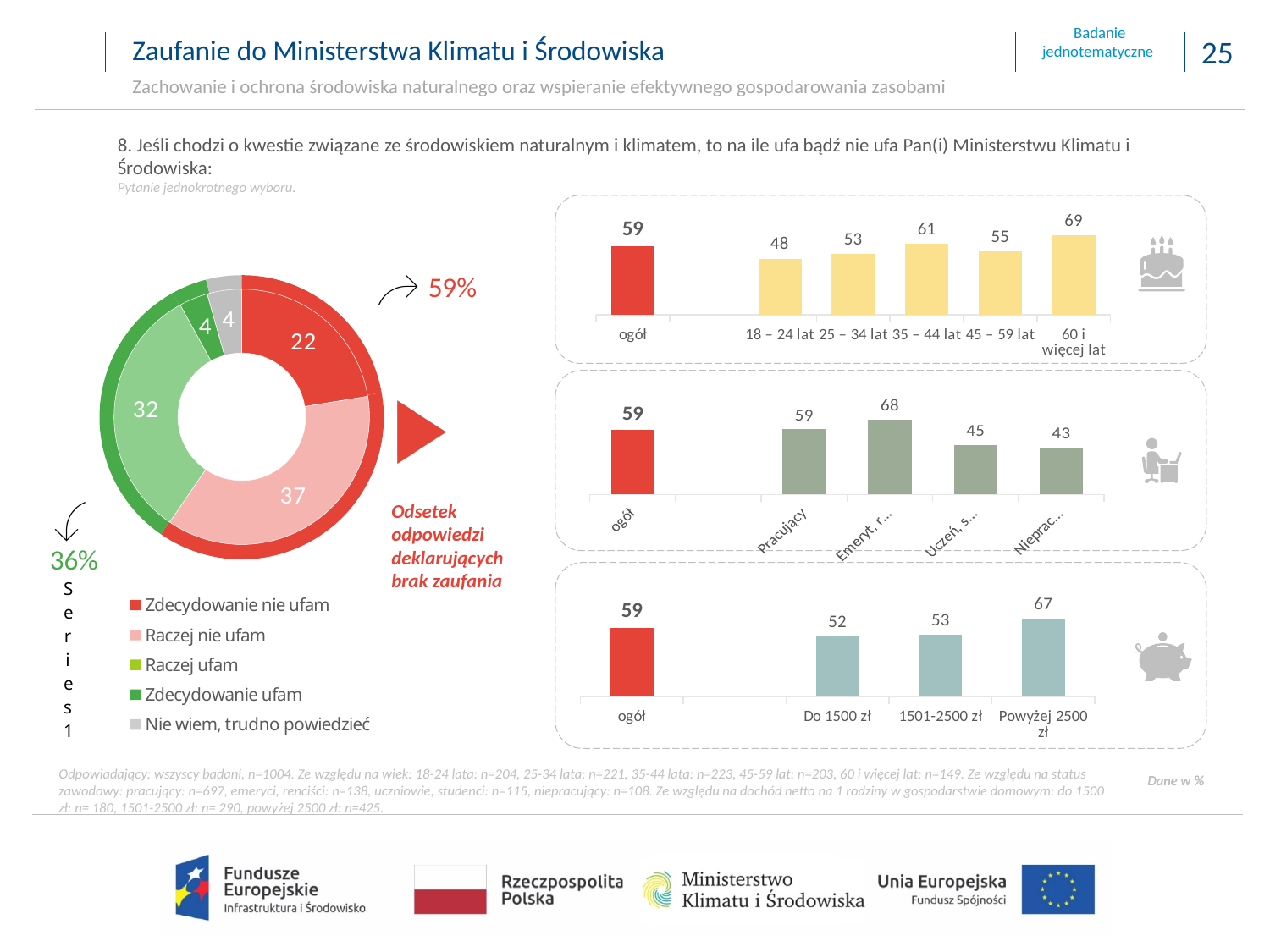
In the top bar chart on the right (by age), what is the value for the 60 i więcej lat group? 69 In the bottom bar chart on the right (by income), what is the value for Powyżej 2500 zł? 67 In the middle bar chart on the right (by employment status), what is the value for Pracujący? 59 What type of chart is the chart on the left side of the slide? Donut chart In the top bar chart on the right (by age), what is the difference between the 60 i więcej lat group and the 18 – 24 lat group? 21 How many entries does the legend of the donut chart on the left list? 5 In the top bar chart on the right (by age), which age group has the lowest value? 18 – 24 lat In the donut chart on the left, what percentage of respondents answered "Raczej nie ufam"? 37 In the middle bar chart on the right (by employment status), how many bars are shown? 5 In the donut chart on the left, what percentage of respondents answered "Zdecydowanie nie ufam"? 22 In the bottom bar chart on the right (by income), which is larger: Do 1500 zł or 1501-2500 zł? 1501-2500 zł In the donut chart on the left, which answer category has the largest share? Raczej nie ufam